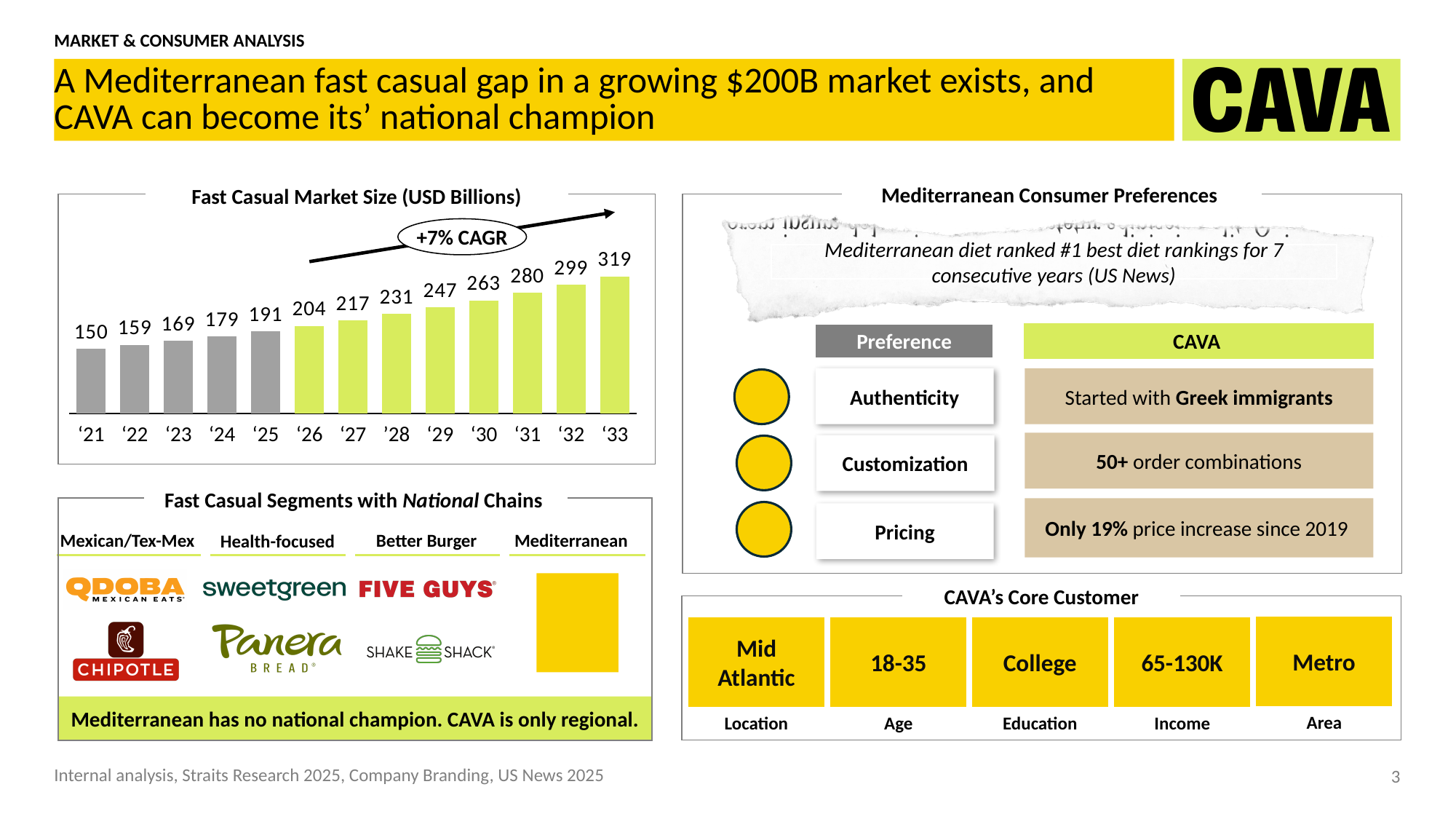
Do the values in the Fast Casual Market Size chart rise or fall from '21 to '33? rise What is the fast casual market size shown for '33? 319 What is the difference between the '33 and '21 values in the Fast Casual Market Size chart? 169 What kind of chart is the Fast Casual Market Size chart? bar chart In the Fast Casual Market Size chart, which is larger, the value for '29 or the value for '24? '29 How many years are plotted in the Fast Casual Market Size chart? 13 What is the fast casual market size shown for '21? 150 Which year has the lowest value in the Fast Casual Market Size chart? '21 What CAGR is annotated on the Fast Casual Market Size chart? +7% CAGR What is the difference between the '26 and '25 values in the Fast Casual Market Size chart? 13 What value is shown for '27 in the Fast Casual Market Size chart? 217 Which year has the highest value in the Fast Casual Market Size chart? '33